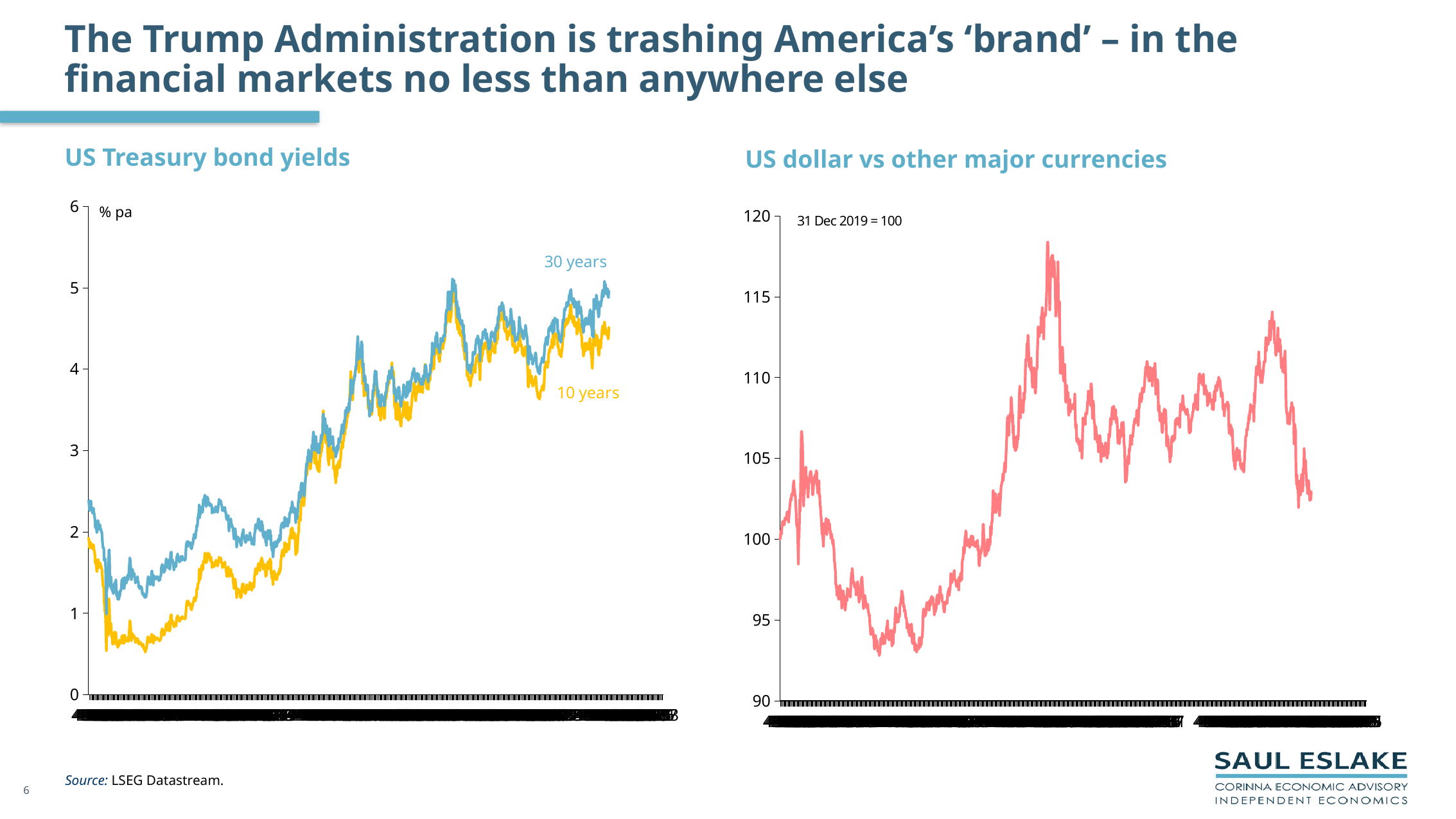
On the 'US Treasury bond yields' chart, is the final value of the 10 years series greater or less than 4? greater On the 'US Treasury bond yields' chart, which two series are labelled? 30 years and 10 years On the 'US Treasury bond yields' chart, do the yields overall rise or fall from the left to the right of the chart? rise How many series are plotted on the 'US Treasury bond yields' chart? 2 On the 'US Treasury bond yields' chart, at the right-hand end of the series, which is higher: 30 years or 10 years? 30 years On the 'US dollar vs other major currencies' chart, is the lowest point of the index greater or less than 95? less On the 'US Treasury bond yields' chart, is the lowest value of the 10 years series greater or less than 1? less On the 'US dollar vs other major currencies' chart, what base is the index set to, as noted on the chart? 31 Dec 2019 = 100 How many series are plotted on the 'US dollar vs other major currencies' chart? 1 What kind of chart is the 'US dollar vs other major currencies' chart? line chart What kind of chart is the 'US Treasury bond yields' chart? line chart